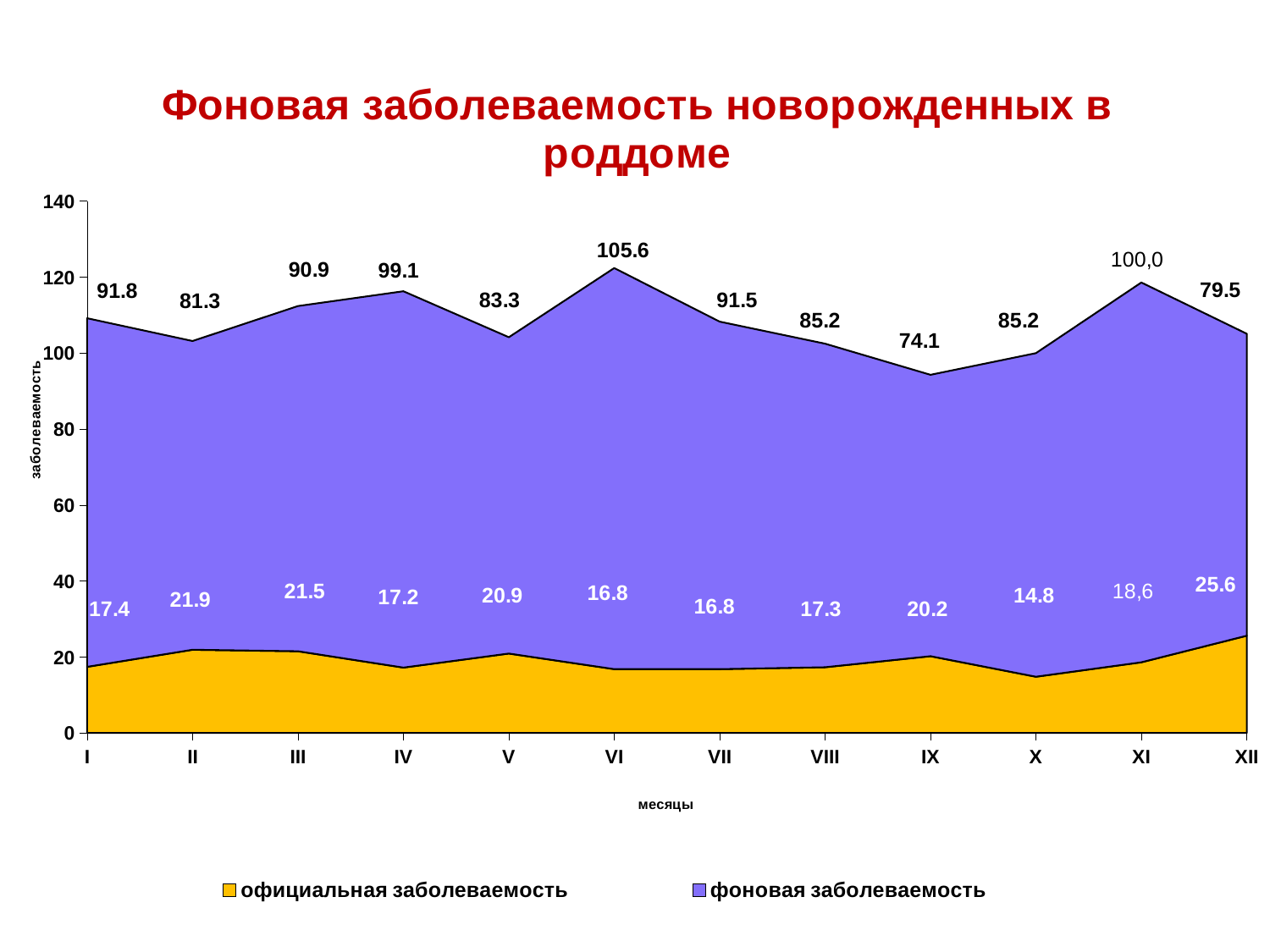
What kind of chart is shown on the slide? Stacked area chart Which month has the lowest официальная заболеваемость? X Which month has the lowest фоновая заболеваемость? IX How many months are shown on the x axis? 12 Which month has the highest фоновая заболеваемость? VI What is the total of официальная and фоновая заболеваемость for month VI? 122.4 What is the value of фоновая заболеваемость for month VI? 105.6 How many series does the legend list? 2 What is the value of официальная заболеваемость for month XII? 25.6 What is the difference between the highest and lowest фоновая заболеваемость values (months VI and IX)? 31.5 Which is larger: фоновая заболеваемость in month IV or in month V? Month IV (99.1) What is the value of официальная заболеваемость for month II? 21.9